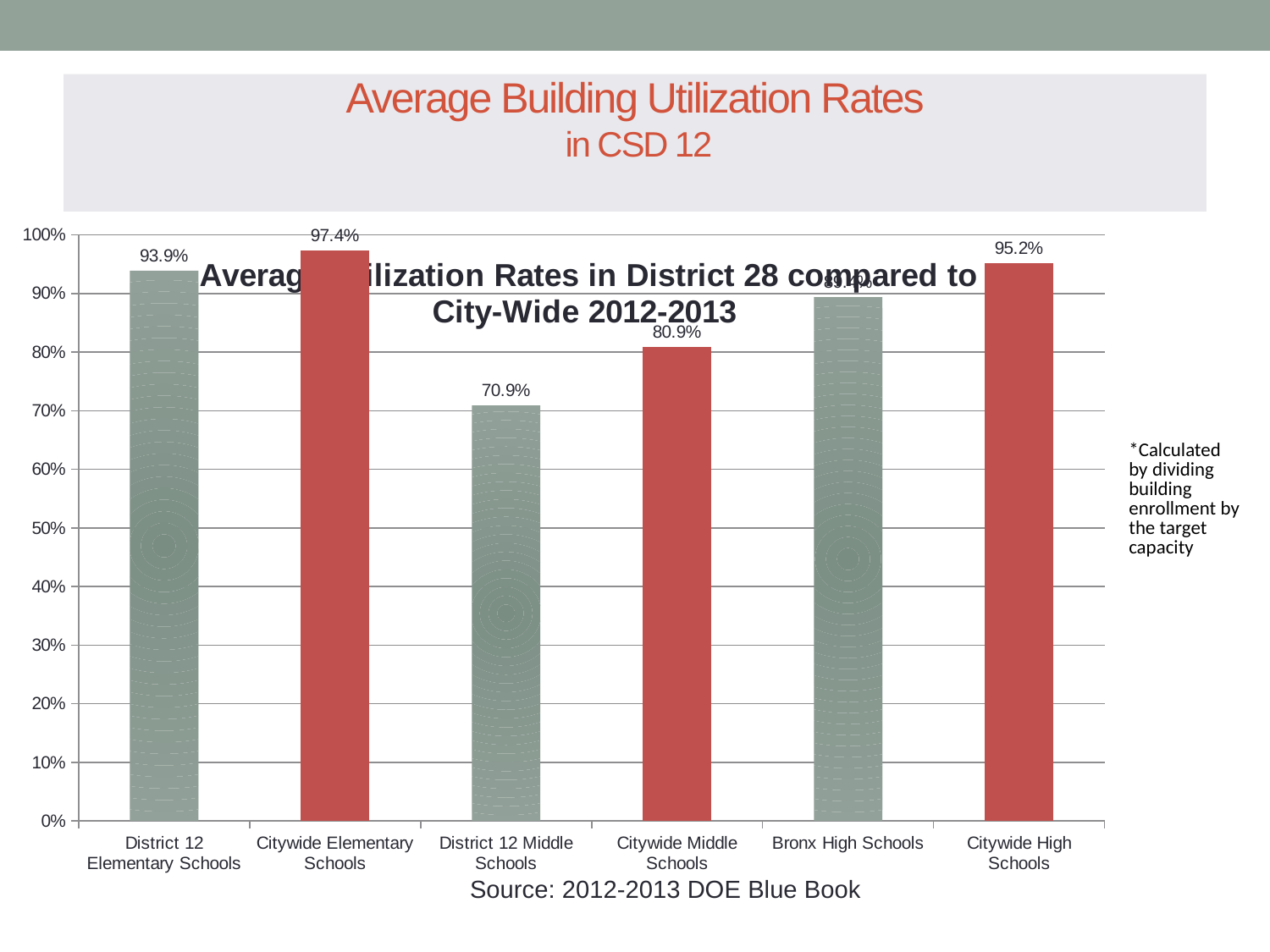
What is the utilization rate shown for Citywide Elementary Schools? 97.4% What is the utilization rate shown for Citywide Middle Schools? 80.9% Which category has the highest utilization rate? Citywide Elementary Schools Is the value for Bronx High Schools greater or less than 80%? greater How many categories are shown on the x axis? 6 What is the utilization rate shown for Citywide High Schools? 95.2% What is the average building utilization rate for District 12 Elementary Schools? 93.9% What kind of chart is shown on the slide? bar chart Which is larger, the rate for District 12 Elementary Schools or for Citywide High Schools? Citywide High Schools Which category has the lowest utilization rate? District 12 Middle Schools How much higher is the Citywide Middle Schools rate than the District 12 Middle Schools rate? 10.0 percentage points What is the utilization rate shown for District 12 Middle Schools? 70.9%